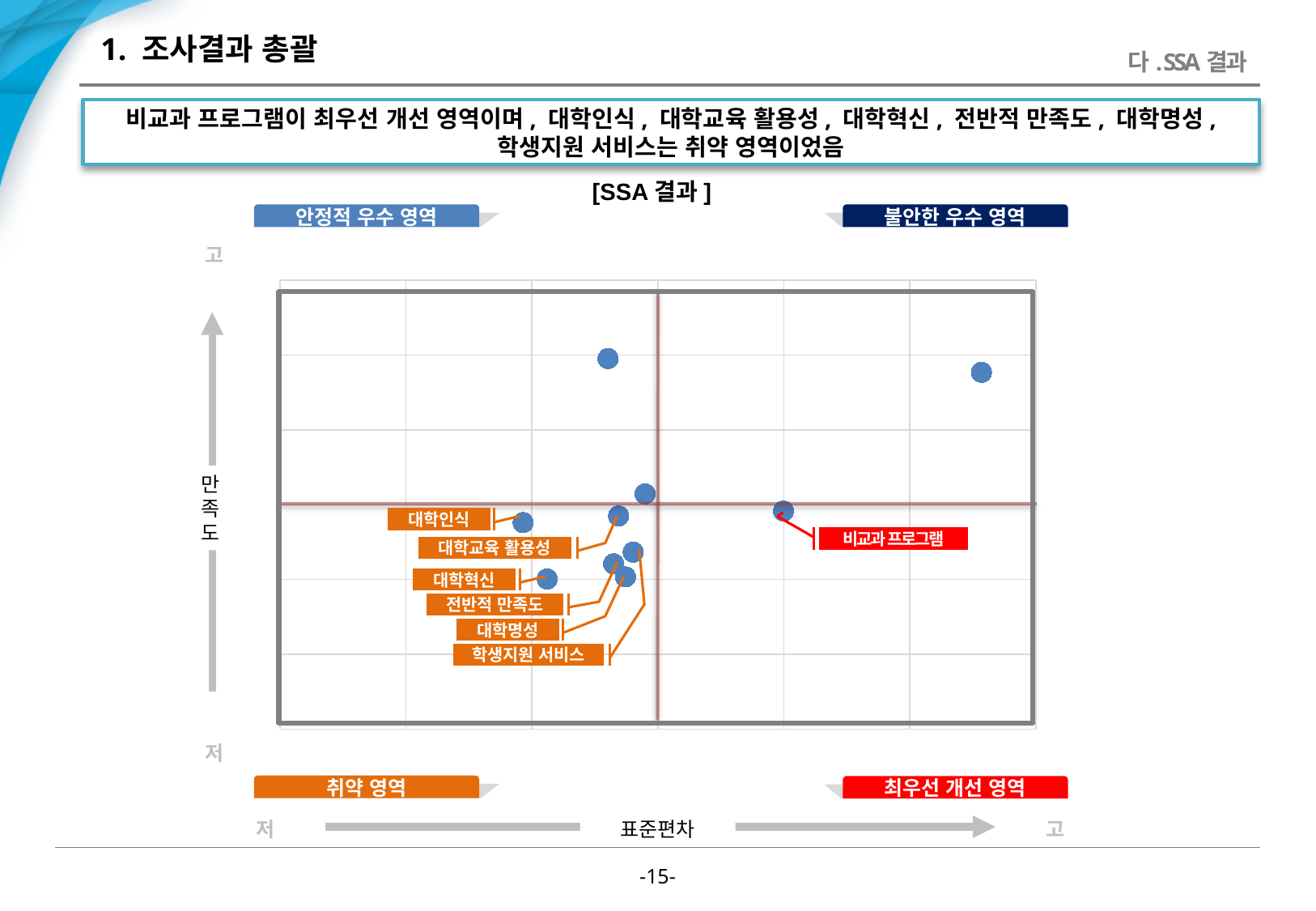
What kind of chart is shown on the slide? scatter chart How many labeled items fall in the 취약 영역 quadrant of the chart? 6 How many data points on the chart have a category label attached? 7 What is the title of the chart? [SSA 결과] What label is given to the horizontal axis of the chart? 표준편차 How many data points lie in the 최우선 개선 영역 quadrant of the chart? 1 Which labeled item has the highest 표준편차 (furthest right) on the chart? 비교과 프로그램 Which has a higher 표준편차 on the chart, 대학인식 or 비교과 프로그램? 비교과 프로그램 Which labeled item falls in the 최우선 개선 영역 quadrant of the chart? 비교과 프로그램 Which has a higher 만족도 on the chart, 대학인식 or 대학혁신? 대학인식 Which labeled item has the lowest 표준편차 (furthest left) on the chart? 대학인식 Which has a higher 만족도 on the chart, 학생지원 서비스 or 대학명성? 학생지원 서비스